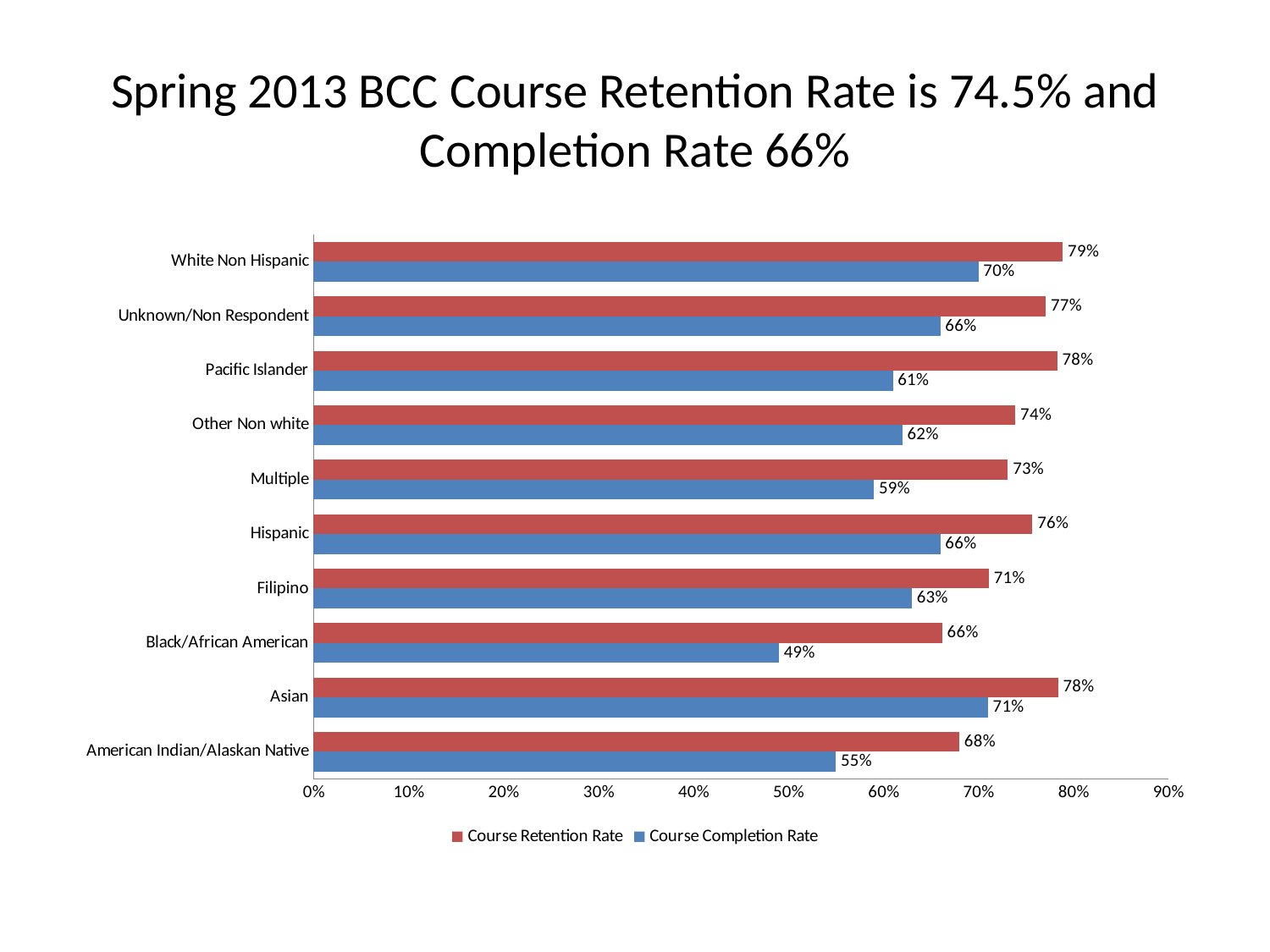
How many categories are shown on the chart? 10 What is the difference between the Course Retention Rate and the Course Completion Rate for Black/African American students? 17% Which category has the highest Course Retention Rate? White Non Hispanic Which is larger: the Course Completion Rate for Filipino students or for Multiple? Filipino Which colour represents the Course Completion Rate in the chart? Blue What is the Course Retention Rate for Black/African American students? 66% What is the Course Completion Rate for Asian students? 71% What is the Course Completion Rate for Pacific Islander students? 61% How many series does the legend list? 2 What kind of chart is shown on the slide? Bar chart Which category has the lowest Course Completion Rate? Black/African American What is the difference between the Course Retention Rate for White Non Hispanic and for American Indian/Alaskan Native? 11%